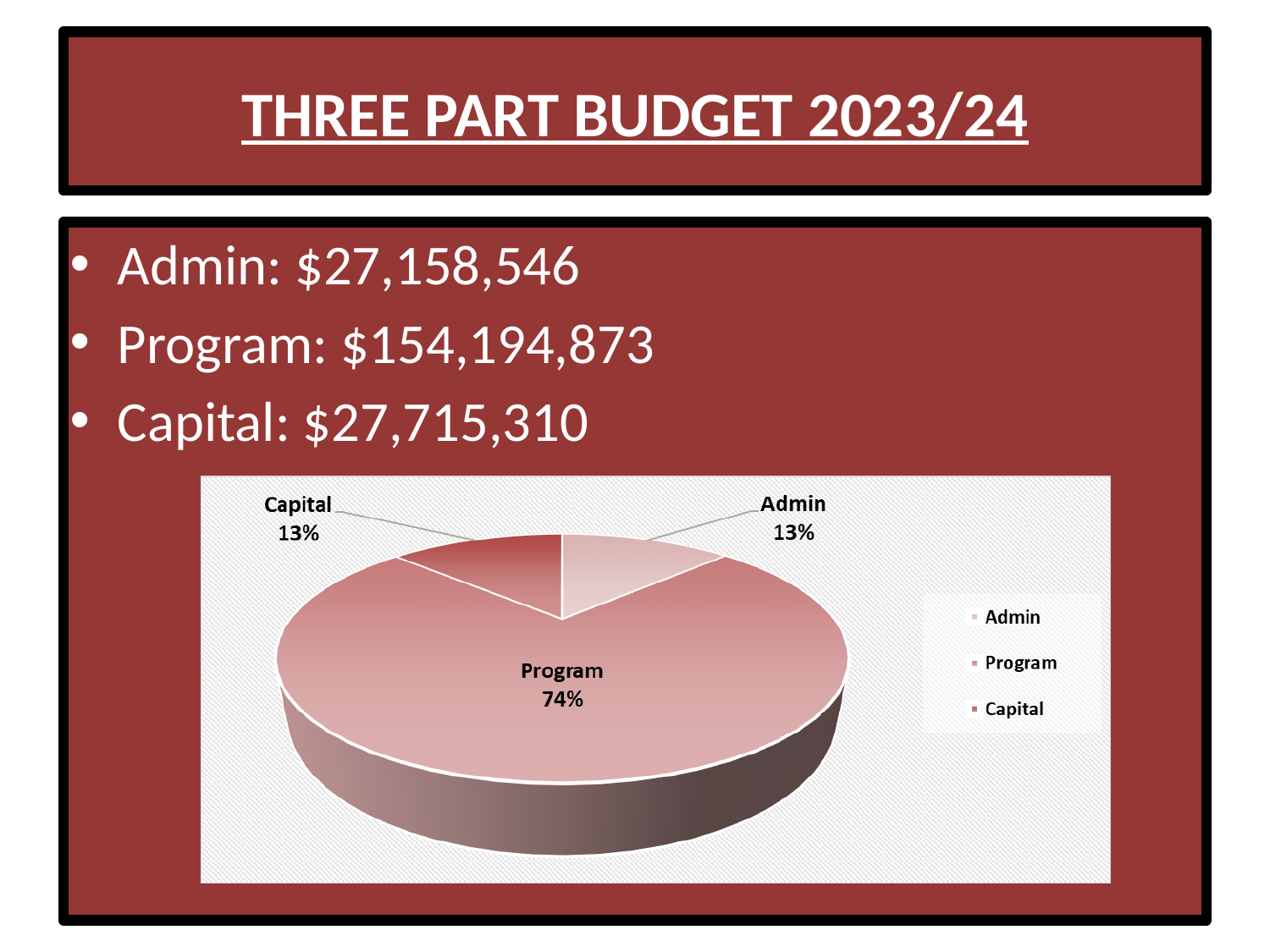
How many entries does the chart legend list? 3 By how many percentage points does the Program share exceed the Admin share? 61 What share of the pie does Program represent? 74% Is the Program share of the pie greater or less than 50%? greater What share of the pie does Admin represent? 13% What kind of chart is shown on the slide? pie chart Which slice of the pie chart is the largest? Program What is the title of the slide containing the pie chart? THREE PART BUDGET 2023/24 Which legend entry is listed first in the pie chart's legend? Admin How many slices does the pie chart have? 3 What share of the pie does Capital represent? 13% Which is larger in the pie chart, Program or Capital? Program